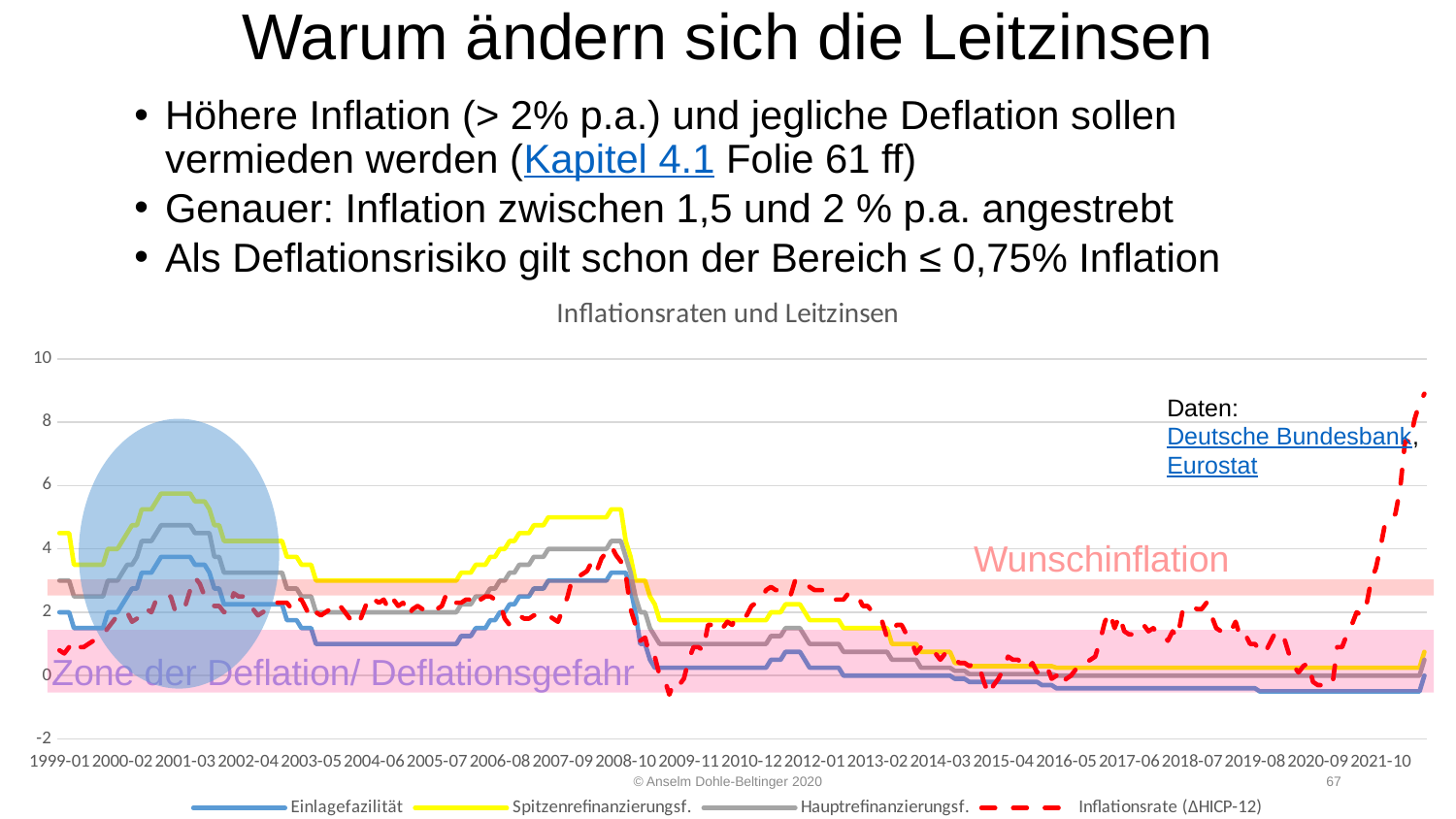
What kind of chart is shown on the slide? line chart Is the value of Hauptrefinanzierungsf. around 2001-03 greater or less than 4? greater Is the value of Spitzenrefinanzierungsf. around 2001-03 greater or less than 4? greater How many series does the legend of the chart list? 4 Is the value of Einlagefazilität around 2019-08 greater or less than 0? less Which series in the chart is drawn as a red dashed line? Inflationsrate (ΔHICP-12) Does the Einlagefazilität rise or fall between 2008-10 and 2009-11? fall Does the Inflationsrate (ΔHICP-12) rise or fall between 2020-09 and 2021-10? rise What is the title of the chart? Inflationsraten und Leitzinsen Around 2001-03, which is higher: Spitzenrefinanzierungsf. or Einlagefazilität? Spitzenrefinanzierungsf.